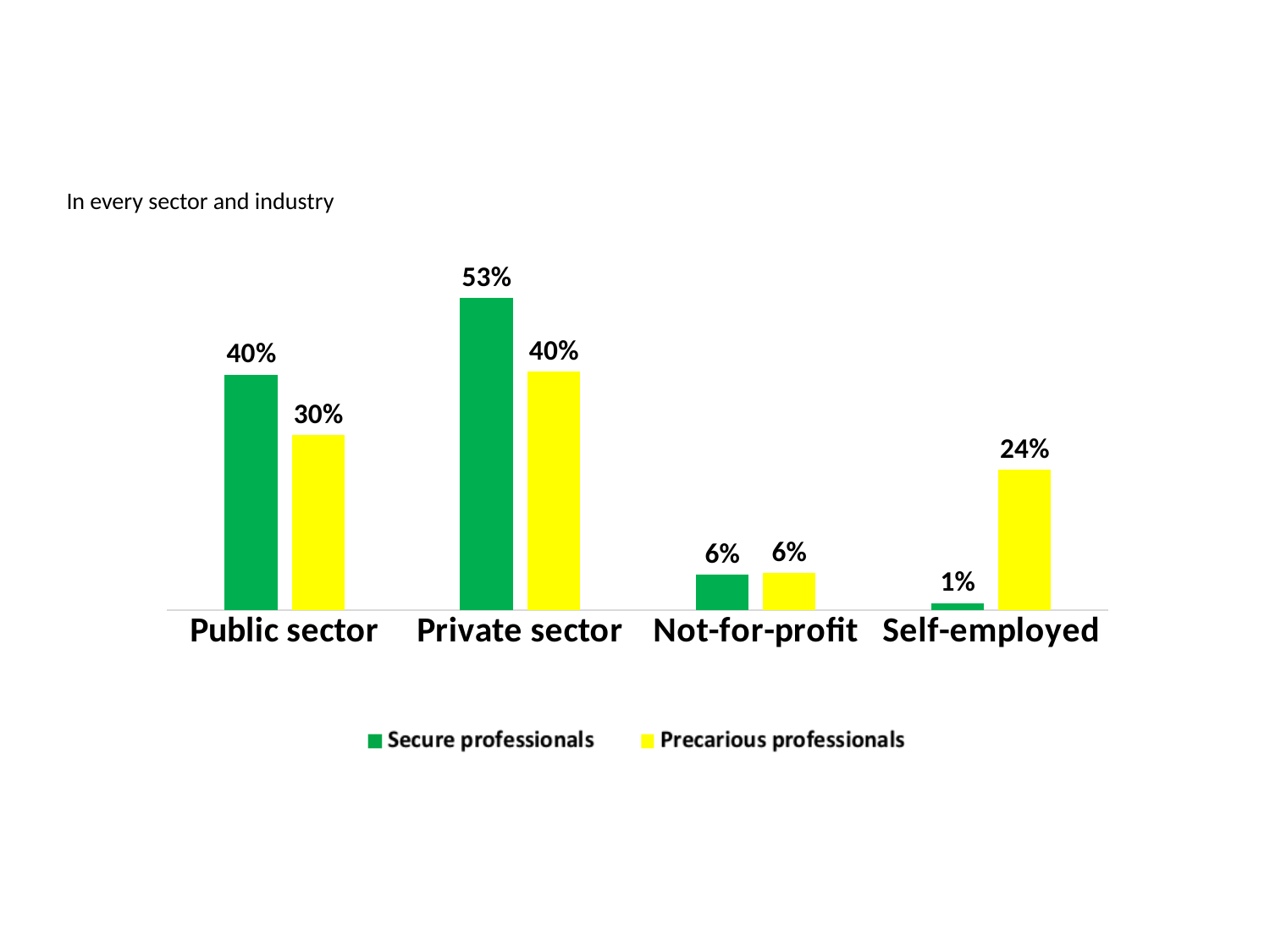
What is the difference between Secure professionals and Precarious professionals in the Private sector? 13% Which category has the lowest value for Precarious professionals? Not-for-profit Which category has the highest value for Secure professionals? Private sector How many series does the legend list? 2 What is the value for Precarious professionals in the Public sector? 30% What is the difference between Precarious professionals and Secure professionals in the Self-employed category? 23% Which category has the lowest value for Secure professionals? Self-employed What is the value for Secure professionals in the Private sector? 53% Which is larger in the Public sector: Secure professionals or Precarious professionals? Secure professionals How many categories are shown on the x axis? 4 What is the value for Precarious professionals in the Self-employed category? 24% What kind of chart is shown on the slide? Bar chart